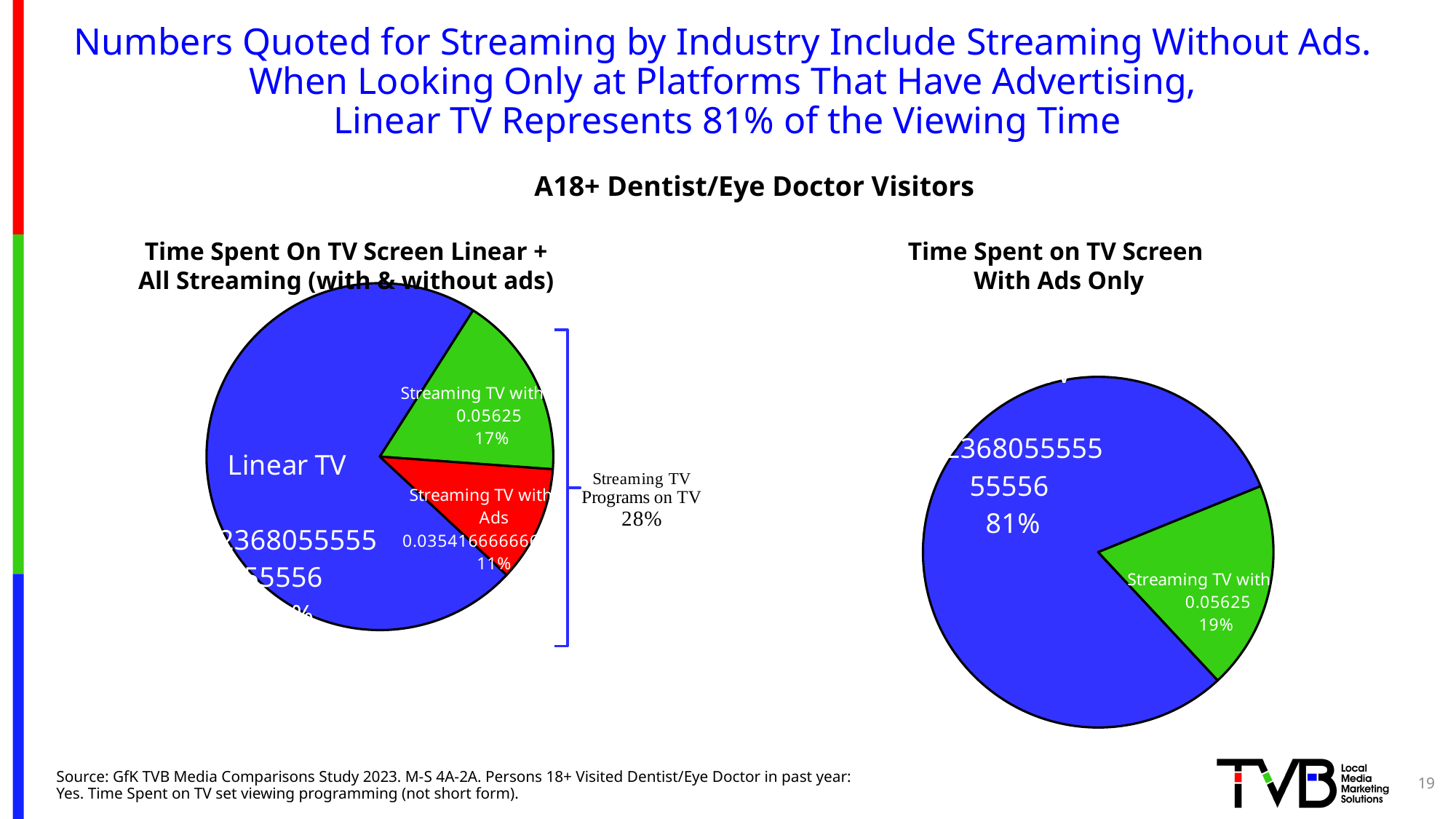
What is the title of the right pie chart? Time Spent on TV Screen With Ads Only What kind of chart is used on this slide? Pie chart In the left pie chart (Linear + All Streaming), what percentage is shown on the green slice? 17% In the right pie chart (Time Spent on TV Screen With Ads Only), what share does the green Streaming TV with Ads slice represent? 19% How many slices does the left pie chart (Linear + All Streaming) have? 3 In the right pie chart (With Ads Only), which category has the largest slice? Linear TV In the left pie chart, which slice is larger, the green slice or the red slice? The green slice How many slices does the right pie chart (With Ads Only) have? 2 In the left pie chart, what percentage does the bracket label 'Streaming TV Programs on TV' show? 28% In the right pie chart (Time Spent on TV Screen With Ads Only), what share of viewing time does Linear TV represent? 81% In the left pie chart, what is the difference in percentage points between the green slice (17%) and the red slice (11%)? 6 percentage points